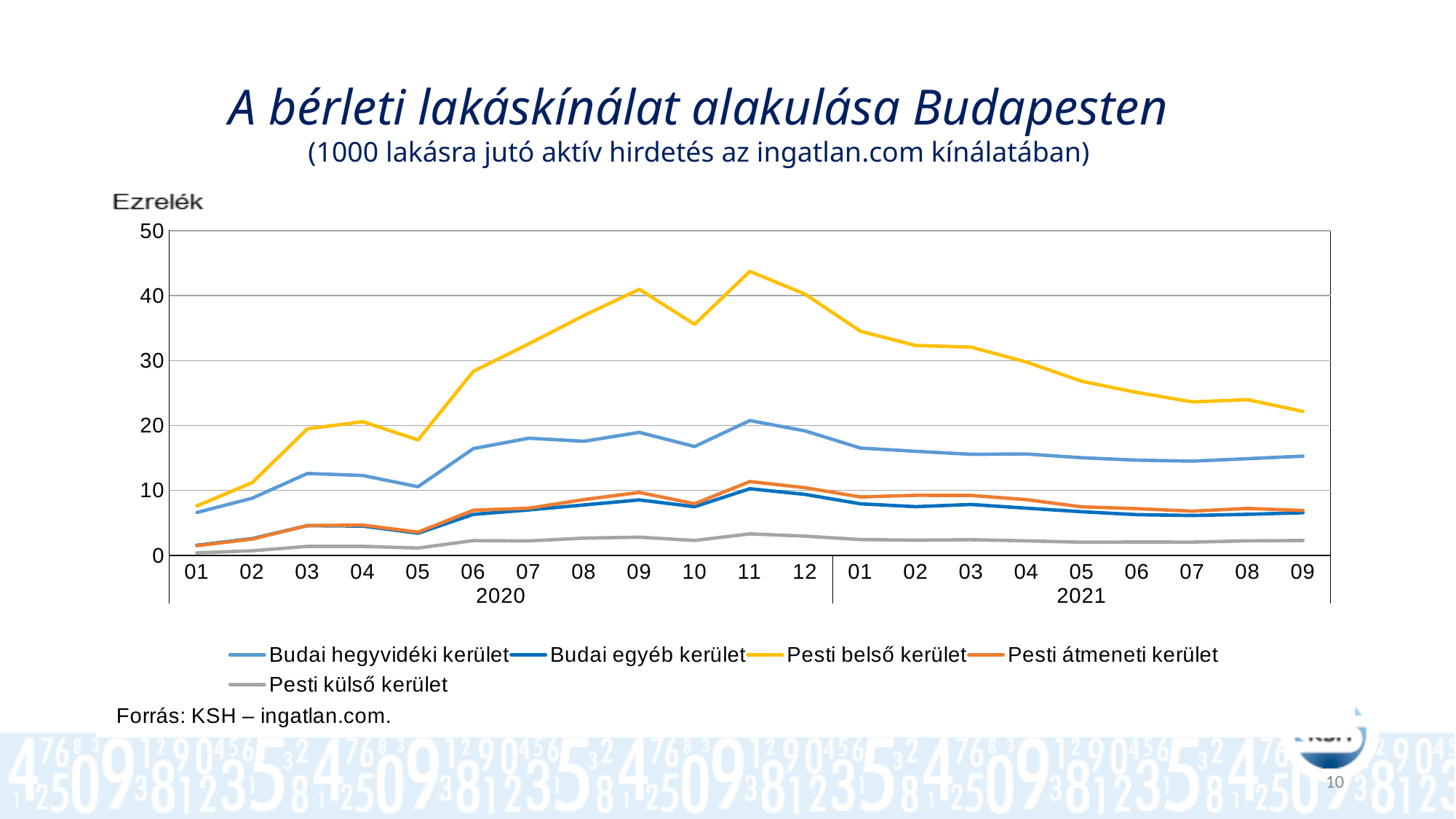
How many series does the legend list? 5 What unit label is shown above the y axis? Ezrelék Is the value for Pesti belső kerület in 2021 09 greater or less than 20? greater In which month does the Pesti belső kerület series reach its peak? 2020 11 Is the value for Pesti belső kerület in 2020 01 greater or less than 10? less Does the Pesti belső kerület series rise or fall from 2020 11 to 2021 09? fall What kind of chart is shown on the slide? line chart Is the value for Pesti belső kerület in 2020 11 greater or less than 40? greater Which is larger in 2020 09: Budai egyéb kerület or Pesti külső kerület? Budai egyéb kerület Which series has the highest values throughout the chart? Pesti belső kerület How many monthly points are plotted along the x axis? 21 Which series has the lowest values throughout the chart? Pesti külső kerület